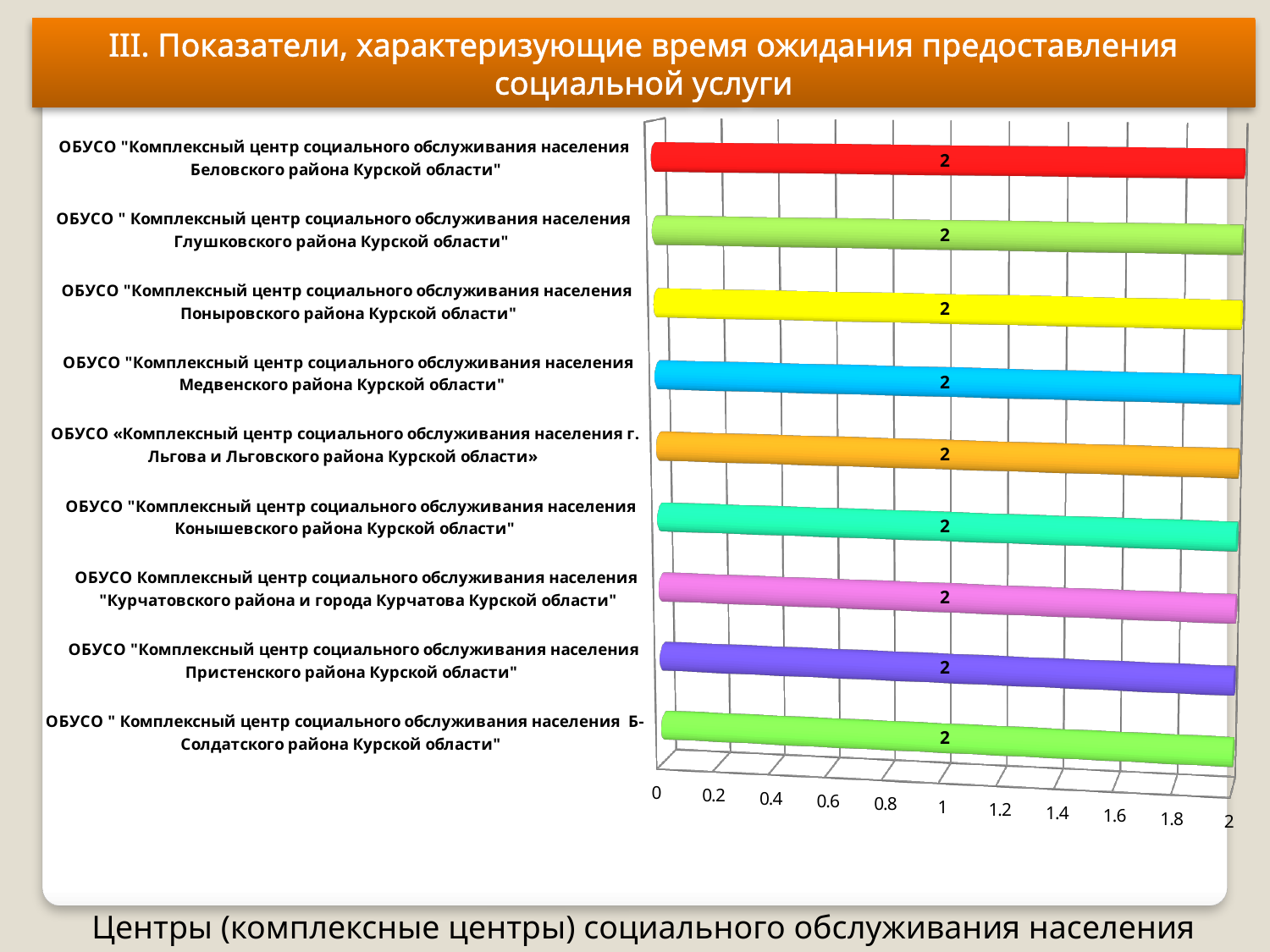
What is the value for ОБУСО "Комплексный центр социального обслуживания населения Пристенского района Курской области"? 2 Is the value for ОБУСО "Комплексный центр социального обслуживания населения Глушковского района Курской области" greater or less than 1.8? greater Do all the bars in the chart have the same value? Yes What is the value for ОБУСО "Комплексный центр социального обслуживания населения Б-Солдатского района Курской области"? 2 What is the difference between the value for the Медвенского района centre and the value for the Конышевского района centre? 0 What is the highest tick value shown on the horizontal axis? 2 What is the value for ОБУСО "Комплексный центр социального обслуживания населения Беловского района Курской области"? 2 What is the value for ОБУСО «Комплексный центр социального обслуживания населения г. Льгова и Льговского района Курской области»? 2 How many categories (bars) does the chart show? 9 Is the value for the Курчатовского района и города Курчатова centre greater or less than 1? greater What is the value for ОБУСО "Комплексный центр социального обслуживания населения Поныровского района Курской области"? 2 What kind of chart is shown on the slide? bar chart